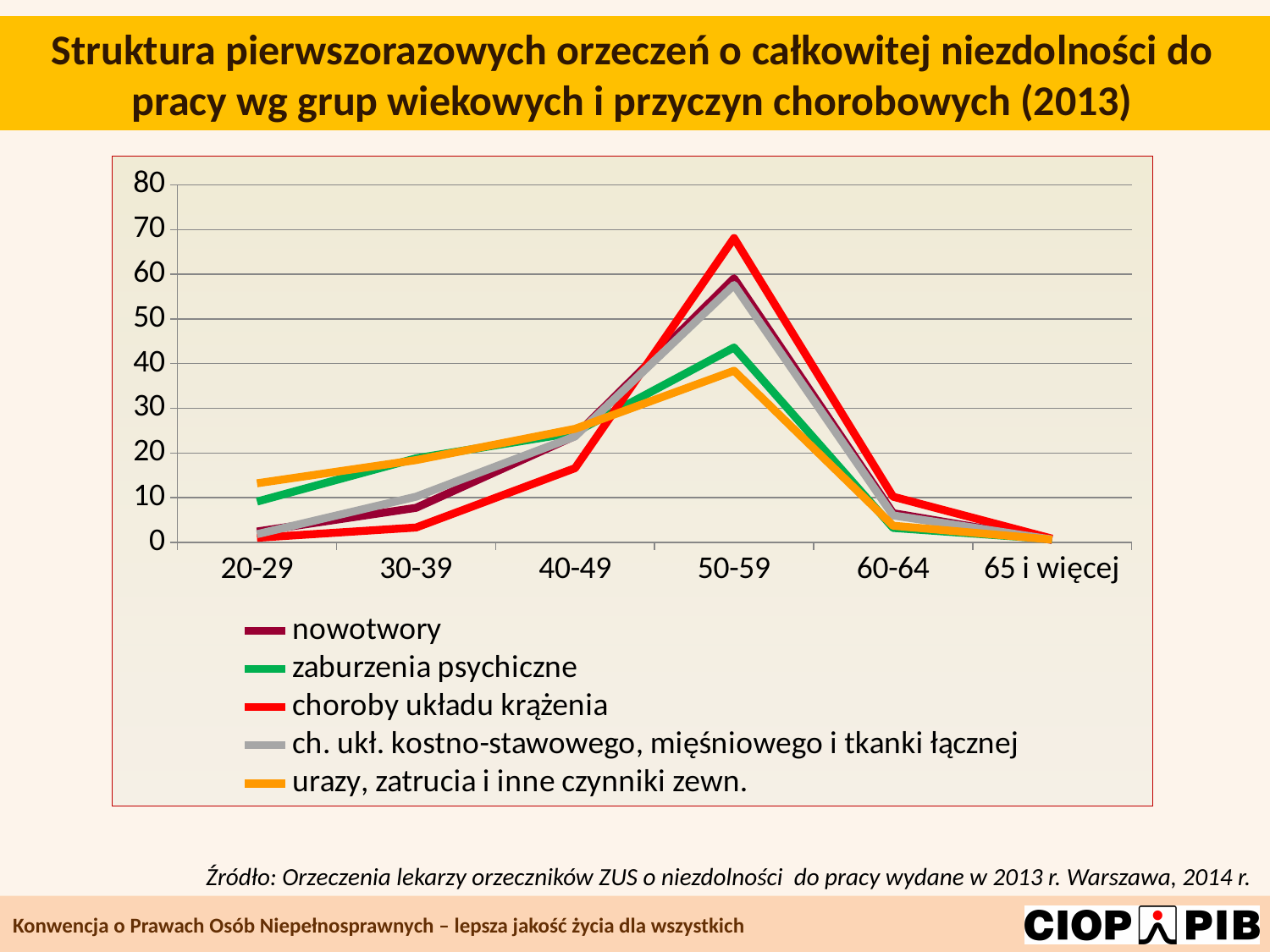
In the 50-59 age group, which is larger: 'choroby układu krążenia' or 'zaburzenia psychiczne'? choroby układu krążenia What colour is the line for 'choroby układu krążenia'? red Is the value for 'urazy, zatrucia i inne czynniki zewn.' in the 50-59 group greater or less than 30? greater Is the value for 'choroby układu krążenia' in the 50-59 group greater or less than 60? greater Is the value for 'nowotwory' in the 30-39 group greater or less than 20? less Do the values of the 'nowotwory' series rise or fall from the 50-59 group to the '65 i więcej' group? fall In which age group does the 'choroby układu krążenia' series reach its highest value? 50-59 How many age groups are shown on the x axis? 6 How many series does the legend list? 5 In the 20-29 age group, which is larger: 'urazy, zatrucia i inne czynniki zewn.' or 'nowotwory'? urazy, zatrucia i inne czynniki zewn. What kind of chart is shown on the slide? line chart Which series has the highest value in the 50-59 age group? choroby układu krążenia